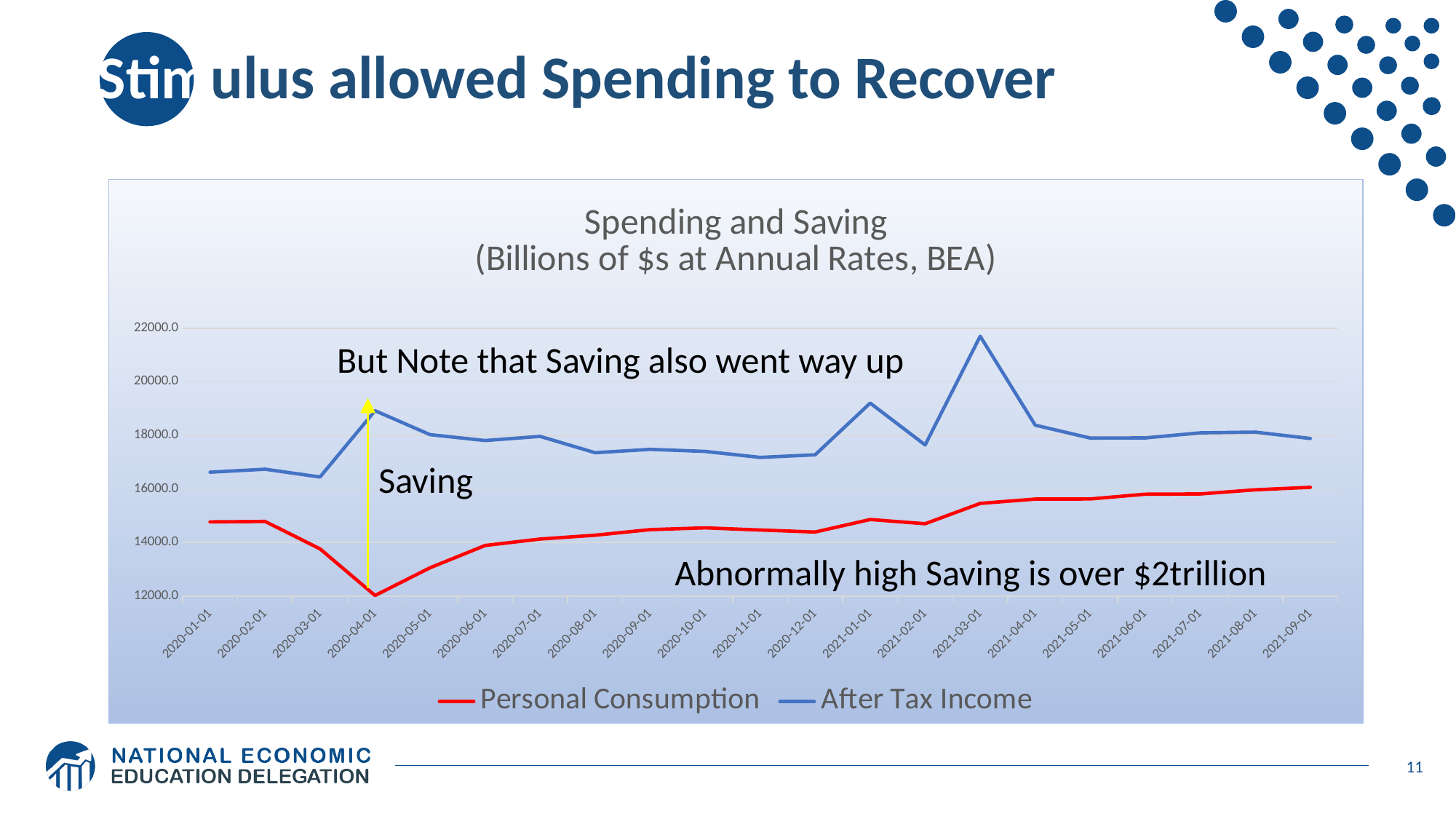
At which date does Personal Consumption reach its lowest value? 2020-04-01 How many series does the legend list? 2 Is the value for Personal Consumption at 2020-04-01 greater or less than 14000.0? less Does After Tax Income rise or fall from 2021-03-01 to 2021-05-01? fall What kind of chart is shown on the slide? line chart At 2020-04-01, which series has the higher value, Personal Consumption or After Tax Income? After Tax Income What is the title of the chart? Spending and Saving (Billions of $s at Annual Rates, BEA) At which date does After Tax Income reach its highest value? 2021-03-01 Is the value for Personal Consumption at 2020-01-01 greater or less than 16000.0? less Does Personal Consumption rise or fall from 2020-04-01 to 2021-09-01? rise Is the value for After Tax Income at 2021-03-01 greater or less than 20000.0? greater How many dates are shown along the x axis? 21